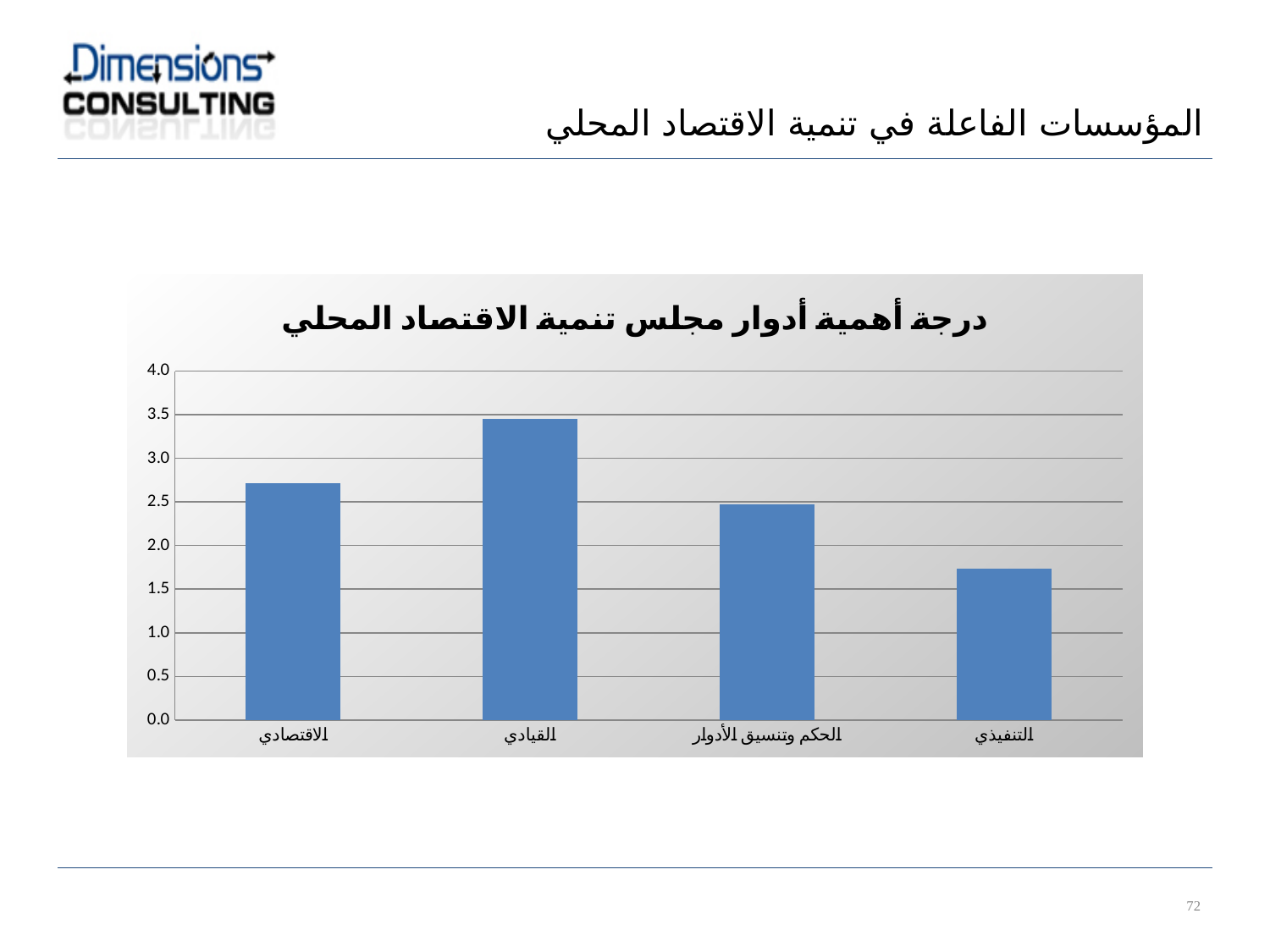
Is the value for الاقتصادي greater or less than 2.5? greater Which has a larger value, الاقتصادي or الحكم وتنسيق الأدوار? الاقتصادي Which has a larger value, القيادي or التنفيذي? القيادي Do the values rise or fall from القيادي to التنفيذي along the x axis? fall Is the value for التنفيذي greater or less than 2.0? less Is the value for القيادي greater or less than 3.0? greater What is the title of the chart? درجة أهمية أدوار مجلس تنمية الاقتصاد المحلي What kind of chart is shown on the slide? bar chart Which category has the highest value in the chart? القيادي How many categories are plotted in the chart? 4 Which category has the lowest value in the chart? التنفيذي